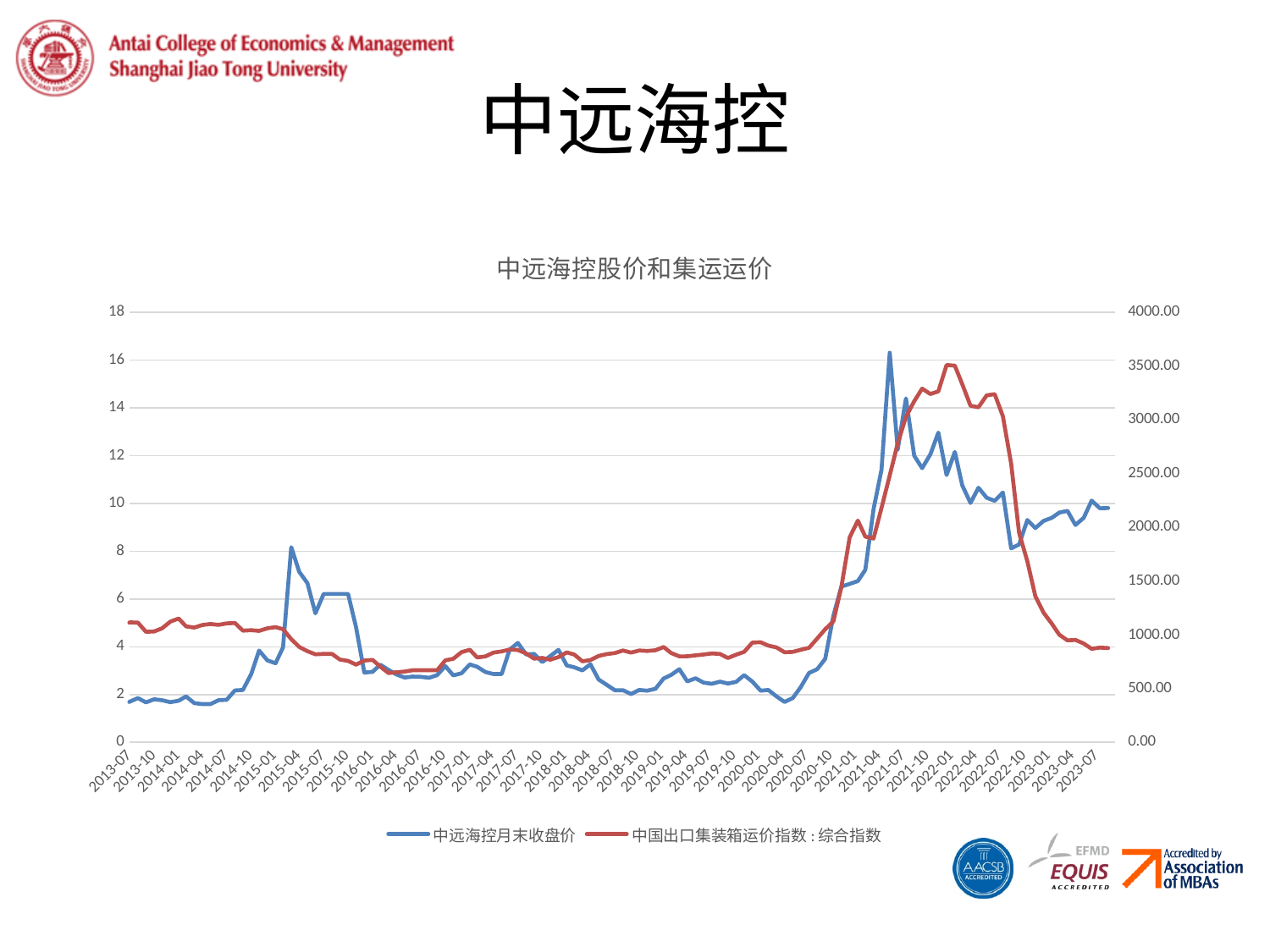
Is the peak value of 中远海控月末收盘价 greater or less than 14? greater What kind of chart is shown on the slide? line chart Does 中国出口集装箱运价指数：综合指数 rise or fall between 2022-04 and 2023-04? fall Around which x-axis label does 中远海控月末收盘价 reach its highest value? 2021-07 Is the value of 中国出口集装箱运价指数：综合指数 at 2023-07 greater or less than 1000.00? less Does 中远海控月末收盘价 rise or fall between 2020-04 and 2021-07? rise Is the peak value of 中国出口集装箱运价指数：综合指数 greater or less than 3000.00? greater What is the title of the chart? 中远海控股价和集运运价 How many series does the legend list? 2 Which series is drawn in red according to the legend? 中国出口集装箱运价指数：综合指数